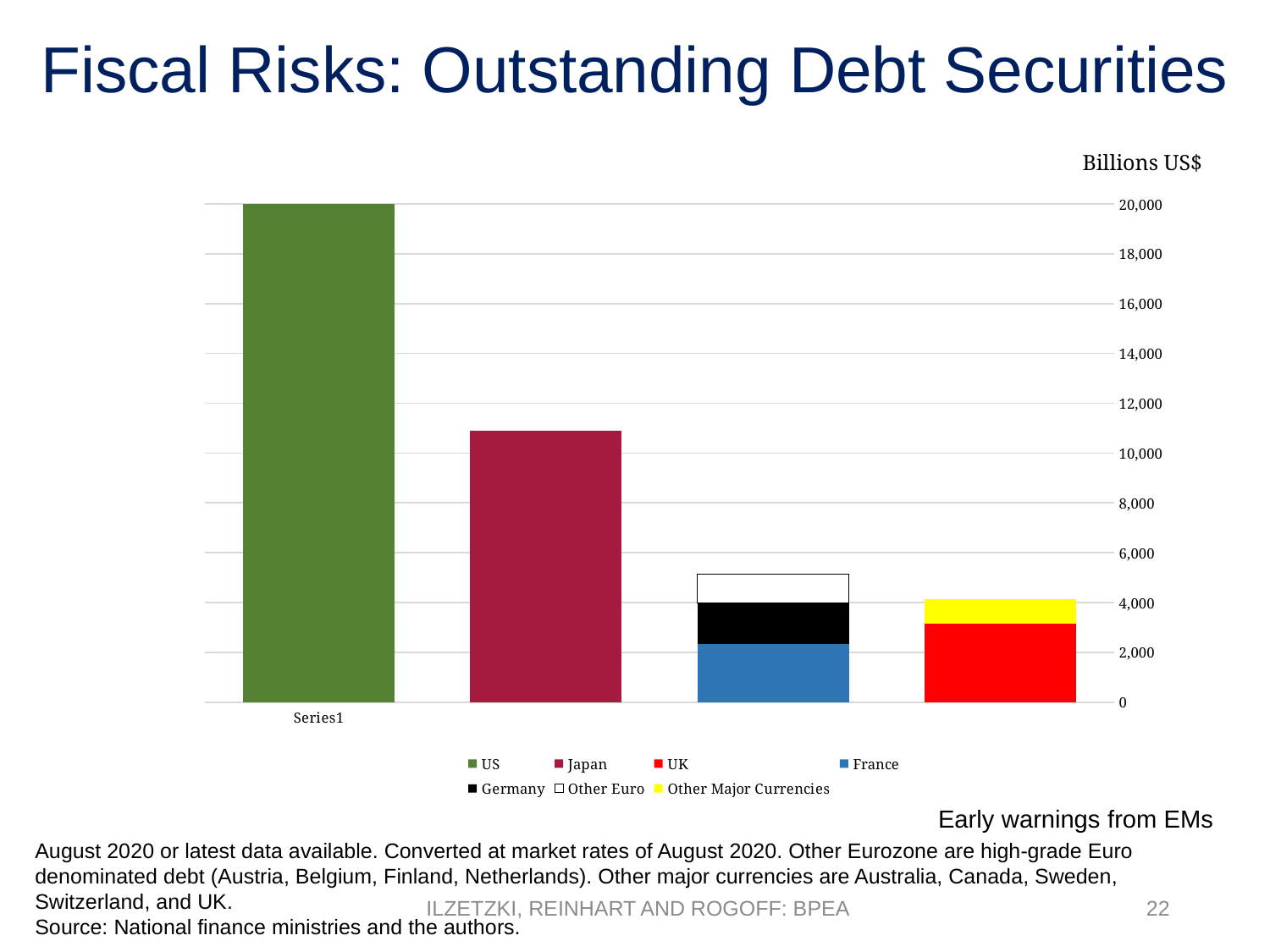
Is the value for US greater or less than 18,000? greater Is the value for France greater or less than 4,000? less Is the value for UK greater or less than 4,000? less What type of chart is shown on the slide? bar chart Which series has the tallest bar? US How many series does the legend list? 7 What unit label is shown above the value axis? Billions US$ What colour represents Other Major Currencies in the legend? yellow Which is larger, the bar for Japan or the bar for UK? Japan Which is larger, the bar for US or the bar for Japan? US